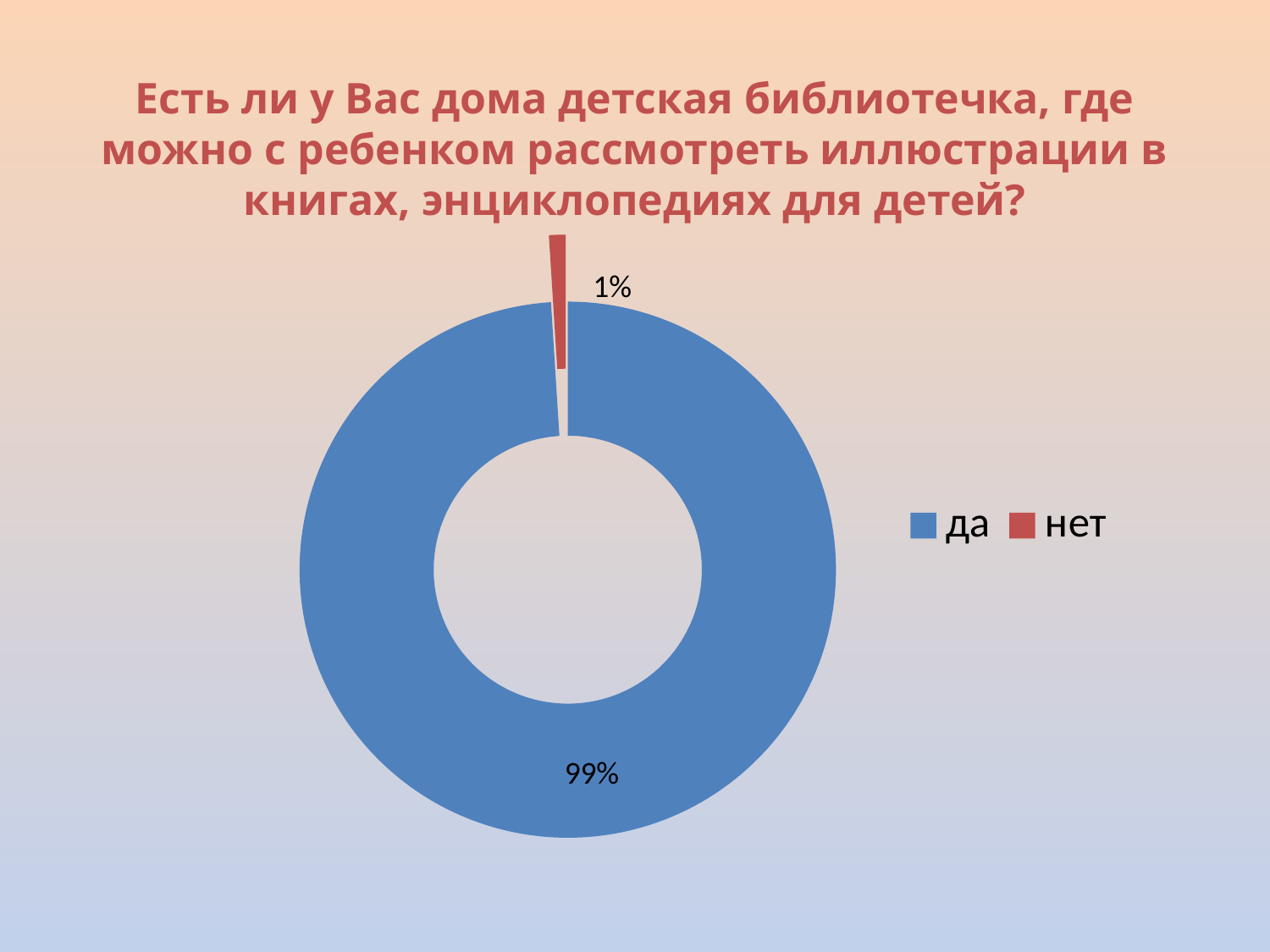
What colour represents the "нет" category? Red What is the difference in percentage points between "да" and "нет"? 98 What percentage of respondents answered "да"? 99% What percentage of respondents answered "нет"? 1% What kind of chart is shown on the slide? Doughnut (pie) chart Which category has the largest share of the chart? да How many entries does the legend list? 2 How many categories does the chart show? 2 Which is larger, the share for "да" or the share for "нет"? да What colour represents the "да" category? Blue Which category has the smallest share of the chart? нет